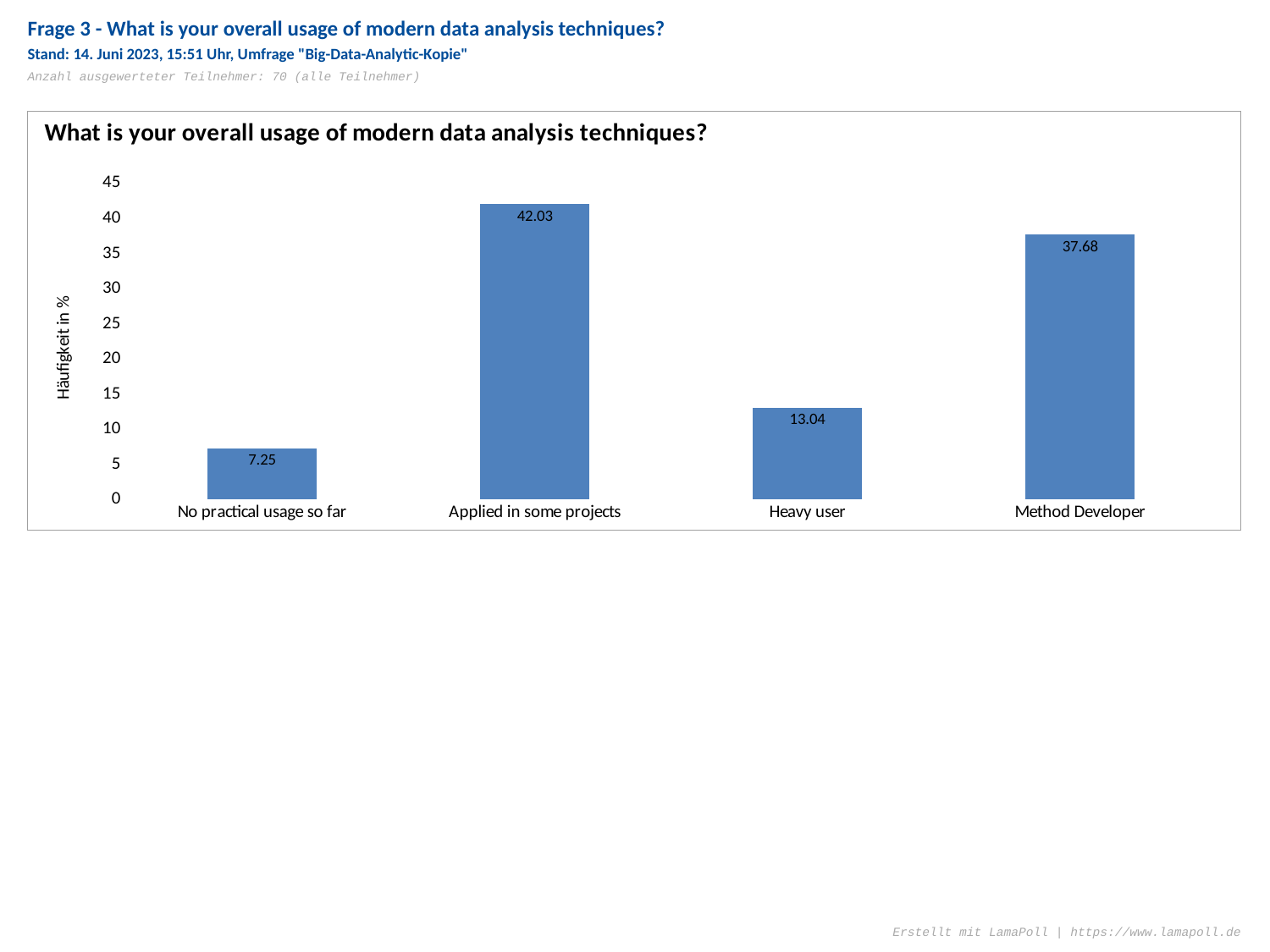
What is the value for "Heavy user"? 13.04 What is the label of the y axis? Häufigkeit in % Which is larger, the value for "Heavy user" or the value for "No practical usage so far"? Heavy user What is the value for "Applied in some projects"? 42.03 How many categories are shown on the x axis? 4 What is the difference between the values for "Applied in some projects" and "Method Developer"? 4.35 What is the value for "No practical usage so far"? 7.25 Is the value for "Method Developer" greater or less than 35? greater What is the value for "Method Developer"? 37.68 Which category has the lowest value? No practical usage so far What kind of chart is shown? bar chart Which category has the highest value? Applied in some projects